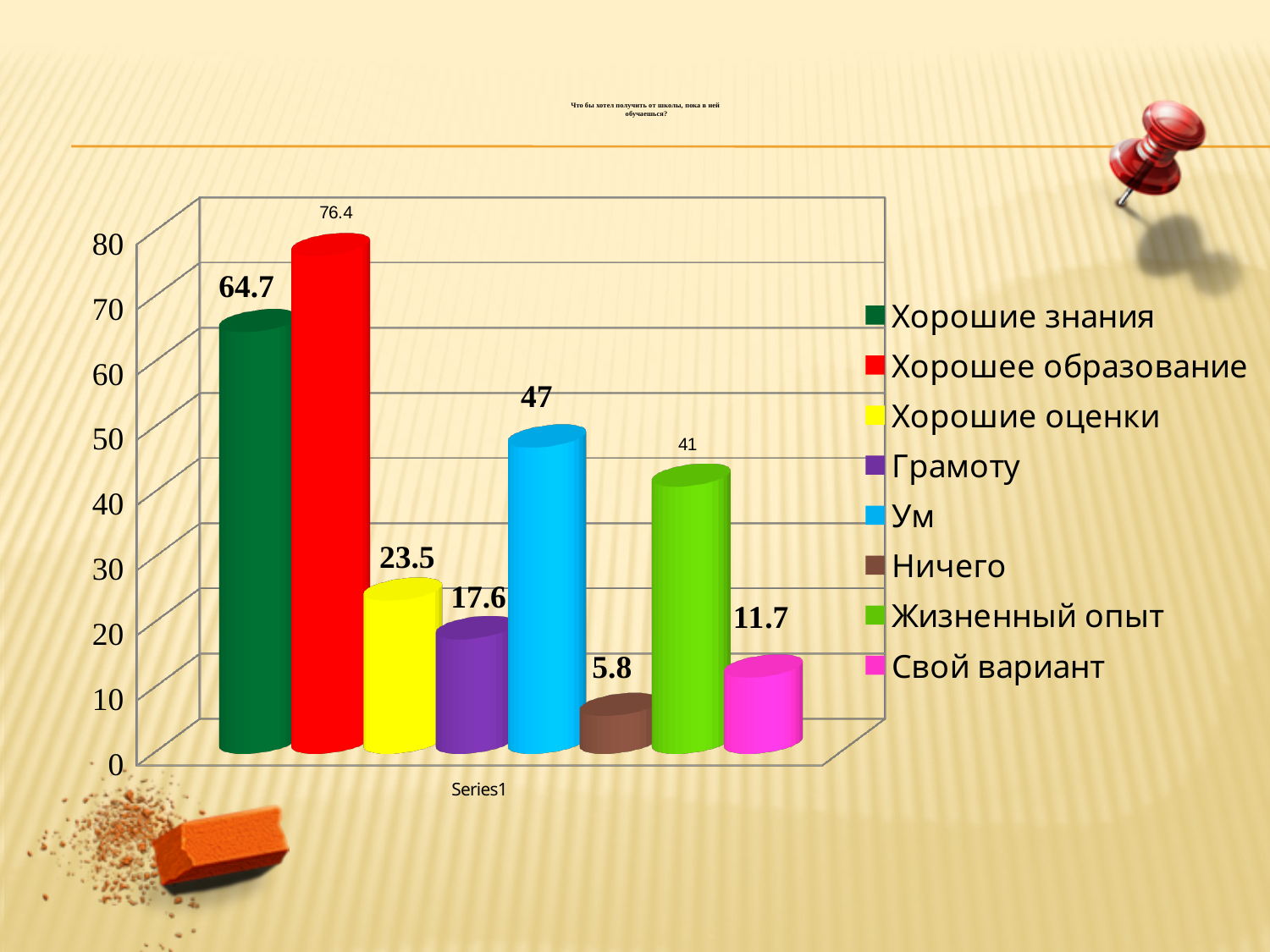
What is the value for Хорошие знания? 64.7 Is the value for Хорошие оценки greater or less than 20? greater What is the difference between the values for Хорошее образование and Хорошие знания? 11.7 Which category has the lowest value? Ничего Which is larger, the value for Ум or the value for Жизненный опыт? Ум What is the value for Ничего? 5.8 Which category has the highest value? Хорошее образование What is the value for Хорошее образование? 76.4 What kind of chart is shown on the slide? bar chart How many bars are shown in the chart? 8 What is the value for Ум? 47 What colour is the bar for Грамоту? purple